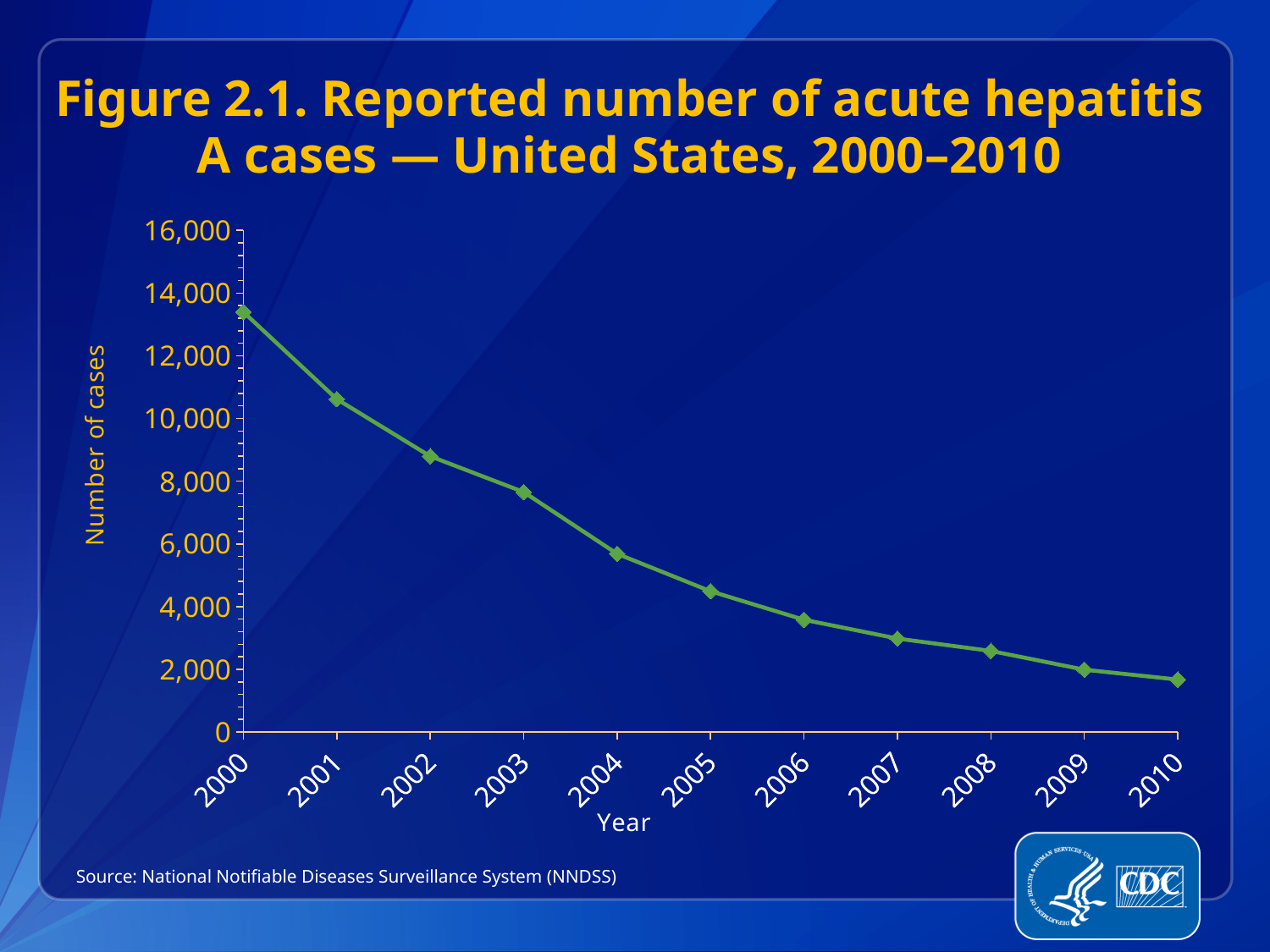
What is the label on the y axis? Number of cases Is the value for 2000 greater or less than 12,000? greater Which year has the highest reported number of acute hepatitis A cases? 2000 Is the value for 2006 greater or less than 4,000? less What is the source cited for the chart data? National Notifiable Diseases Surveillance System (NNDSS) How many years are plotted on the x axis? 11 Is the value for 2010 greater or less than 2,000? less Which year has more reported cases, 2001 or 2004? 2001 What kind of chart is shown on the slide? line chart Which year has the lowest reported number of acute hepatitis A cases? 2010 Do the reported cases rise or fall from 2000 to 2010? fall